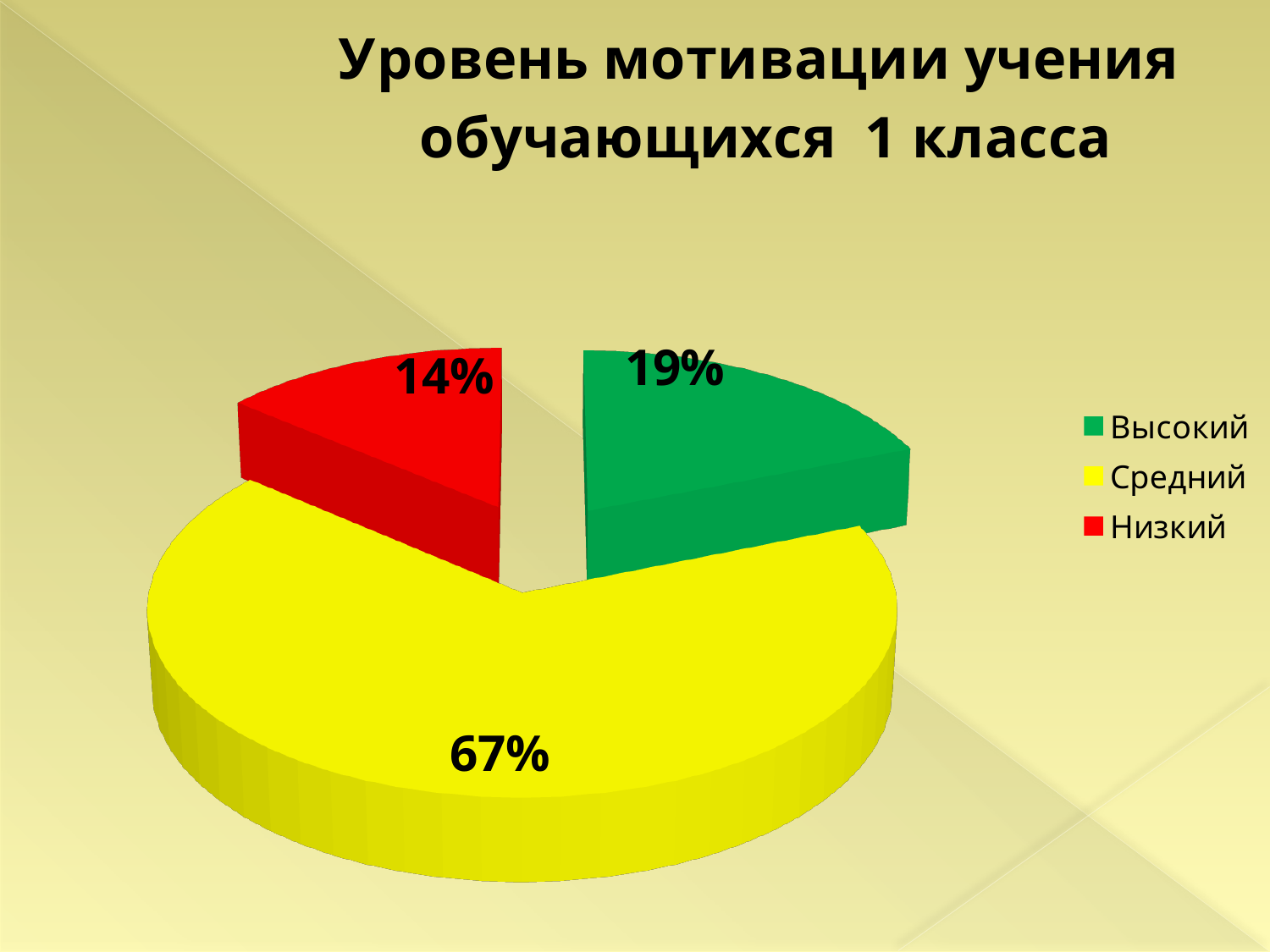
What share of the pie does the Высокий slice represent? 19% Which category has the largest slice of the pie? Средний What is the difference between the Средний and Высокий shares? 48% What colour is the Средний slice? yellow What is the title of the chart? Уровень мотивации учения обучающихся 1 класса Which category has the smallest slice of the pie? Низкий What share of the pie does the Средний slice represent? 67% What share of the pie does the Низкий slice represent? 14% What is the difference between the Высокий and Низкий shares? 5% What kind of chart is shown on the slide? pie chart How many categories does the pie chart have? 3 Which is larger, the Высокий share or the Низкий share? Высокий